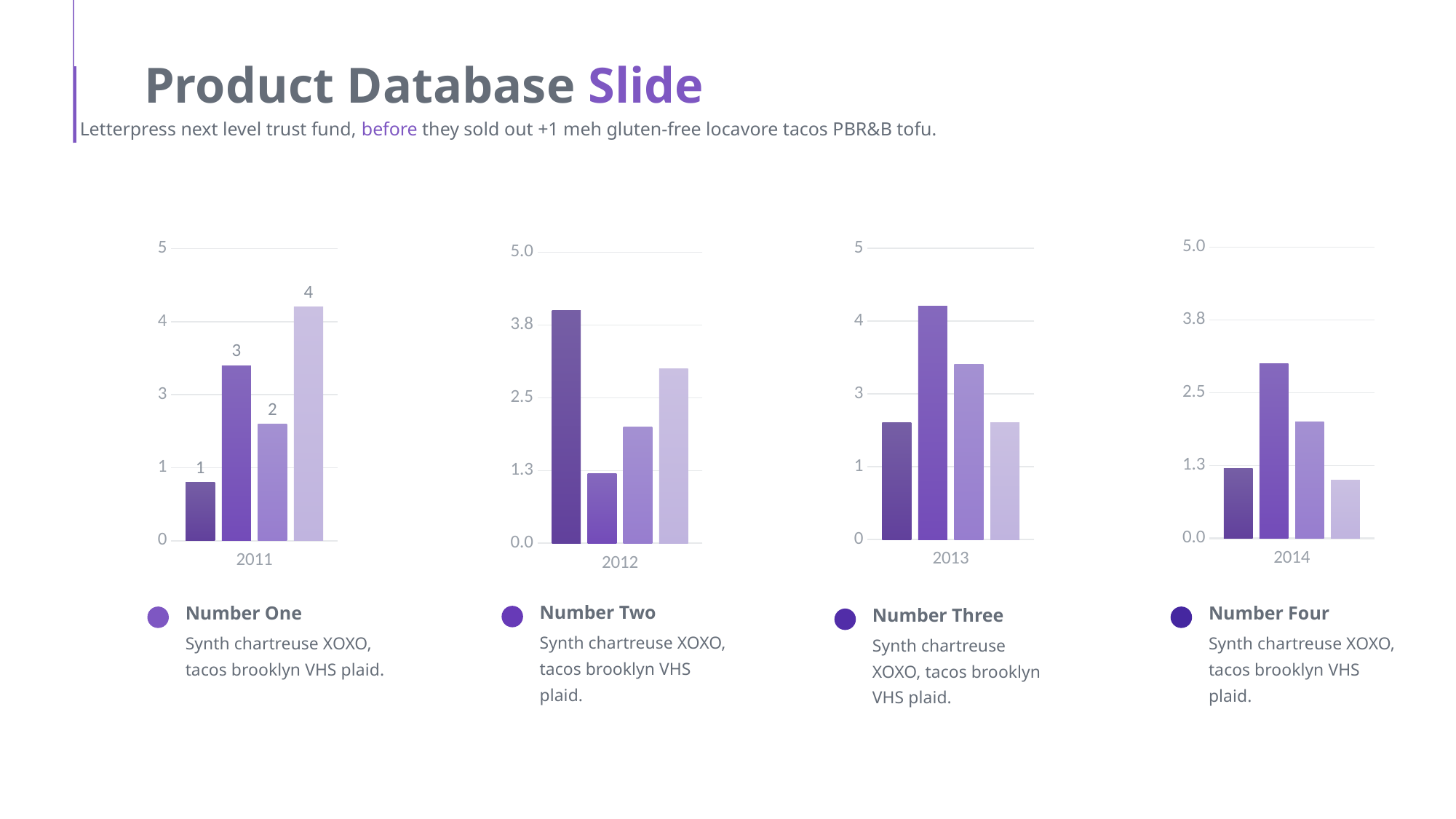
In the 2012 chart, is the value of the first (darkest) bar greater or less than 2.5? greater In the 2012 chart, is the value of the second bar greater or less than 2.5? less In the 2011 chart, which bar is the highest? the fourth (lightest) bar In the 2011 chart, what is the difference between the fourth bar and the second bar? 1 How many bars are shown in the 2012 chart? 4 In the 2014 chart, which is larger, the second bar or the third bar? the second bar In the 2013 chart, which bar is the highest? the second bar How many charts are shown on the slide? 4 In the 2012 chart, which bar is the lowest? the second bar What kind of chart is the leftmost chart (labelled 2011)? bar chart In the 2011 chart, what is the value of the first (darkest) bar? 1 In the 2011 chart, what is the value of the fourth (lightest) bar? 4